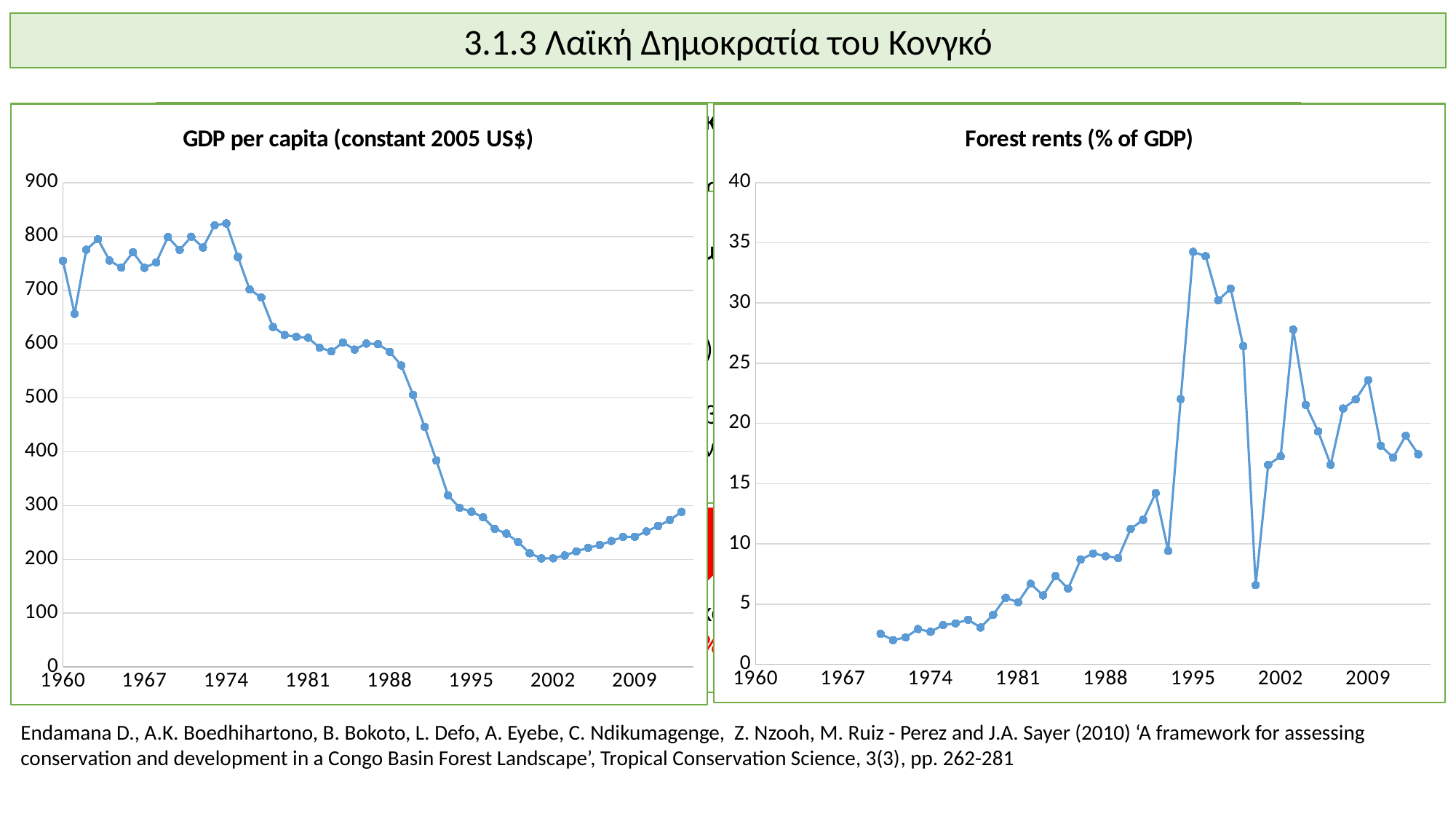
What kind of chart is the right chart titled 'Forest rents (% of GDP)'? line chart In the 'GDP per capita (constant 2005 US$)' chart, is the value for 2002 greater or less than 300? less In the 'GDP per capita (constant 2005 US$)' chart, do the values rise or fall between 1974 and 2002? fall What is the title of the right chart on the slide? Forest rents (% of GDP) In the 'Forest rents (% of GDP)' chart, do the values generally rise or fall between 1974 and 1995? rise In the 'Forest rents (% of GDP)' chart, is the value for 1995 greater or less than 30? greater In the 'GDP per capita (constant 2005 US$)' chart, is the value for 1960 greater or less than 700? greater What kind of chart is the left chart titled 'GDP per capita (constant 2005 US$)'? line chart In the 'GDP per capita (constant 2005 US$)' chart, which year has the larger value, 1960 or 2009? 1960